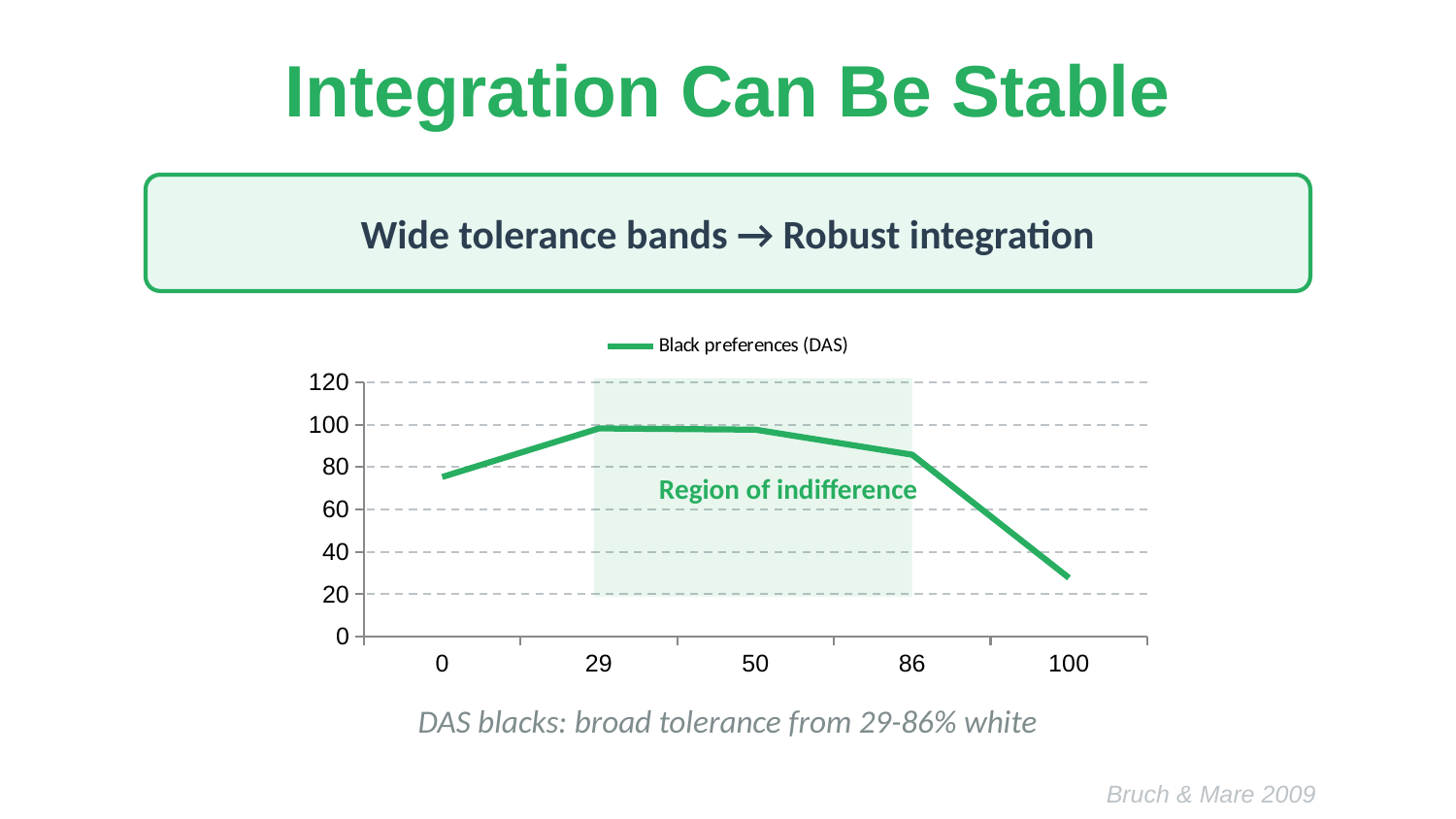
Is the value for Black preferences (DAS) at x = 100 greater or less than 40? less Which is larger, the value for Black preferences (DAS) at x = 0 or at x = 100? x = 0 How many series does the legend list? 1 Is the value for Black preferences (DAS) at x = 86 greater or less than 60? greater What is the name of the series shown in the legend? Black preferences (DAS) What label is written inside the shaded region of the chart? Region of indifference Does the value for Black preferences (DAS) rise or fall between x = 86 and x = 100? fall Is the value for Black preferences (DAS) at x = 29 greater or less than 80? greater Which x-axis category has the lowest value for Black preferences (DAS)? 100 How many points are plotted along the x axis? 5 What kind of chart is shown on the slide? line chart